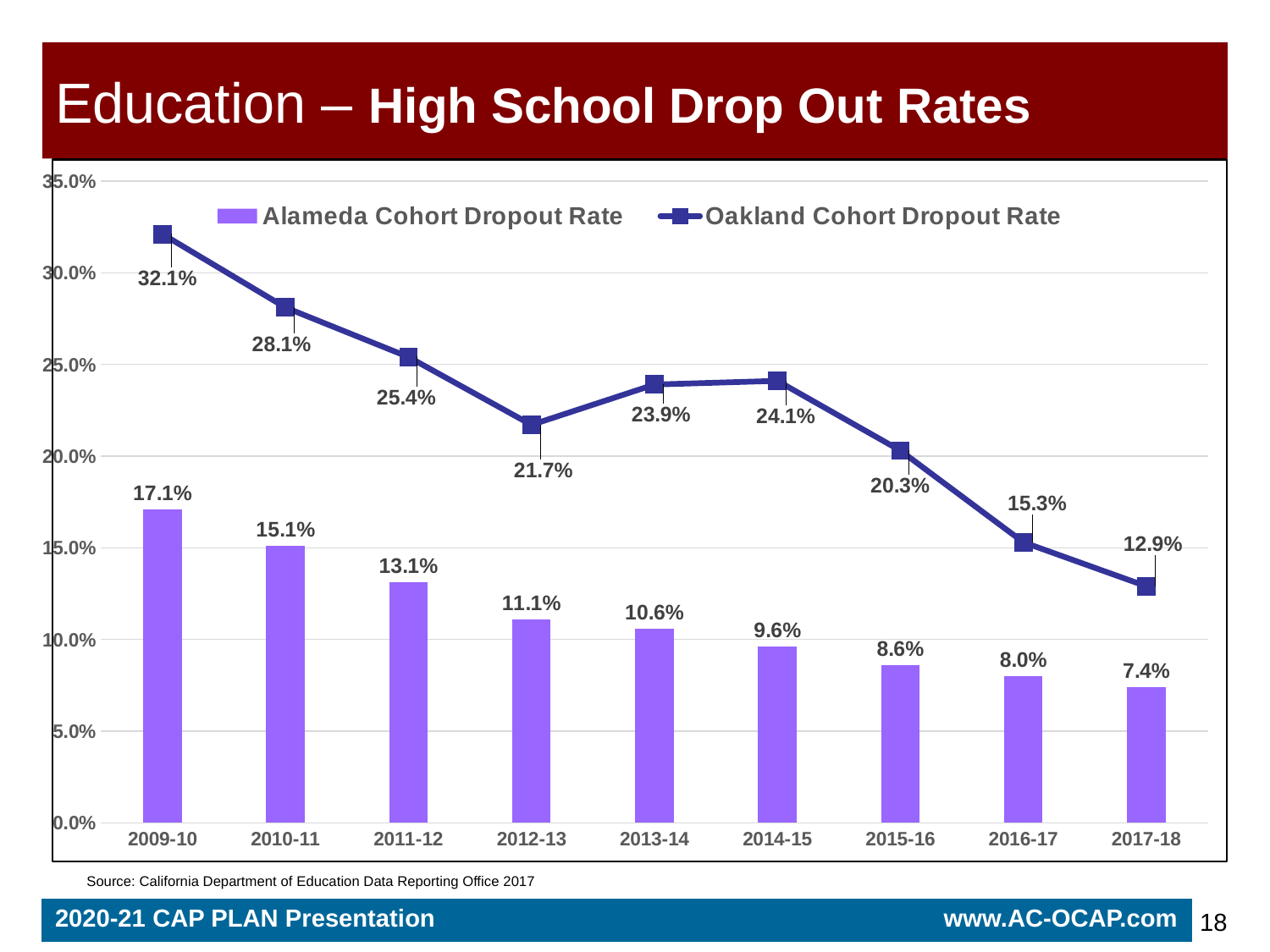
What kind of chart is used for the Alameda Cohort Dropout Rate? Bar chart How many series does the legend list? 2 What colour are the bars for the Alameda Cohort Dropout Rate? Purple Which is larger in 2014-15: the Oakland Cohort Dropout Rate or the Alameda Cohort Dropout Rate? Oakland Cohort Dropout Rate What is the difference between the Oakland and Alameda Cohort Dropout Rates in 2009-10? 15.0% In which year is the Oakland Cohort Dropout Rate highest? 2009-10 What is the Oakland Cohort Dropout Rate for 2015-16? 20.3% How many school years are shown on the x axis? 9 Does the Alameda Cohort Dropout Rate rise or fall from 2009-10 to 2017-18? Fall In which year is the Alameda Cohort Dropout Rate lowest? 2017-18 By how much did the Oakland Cohort Dropout Rate change from 2016-17 to 2017-18? 2.4% What is the Alameda Cohort Dropout Rate for 2012-13? 11.1%